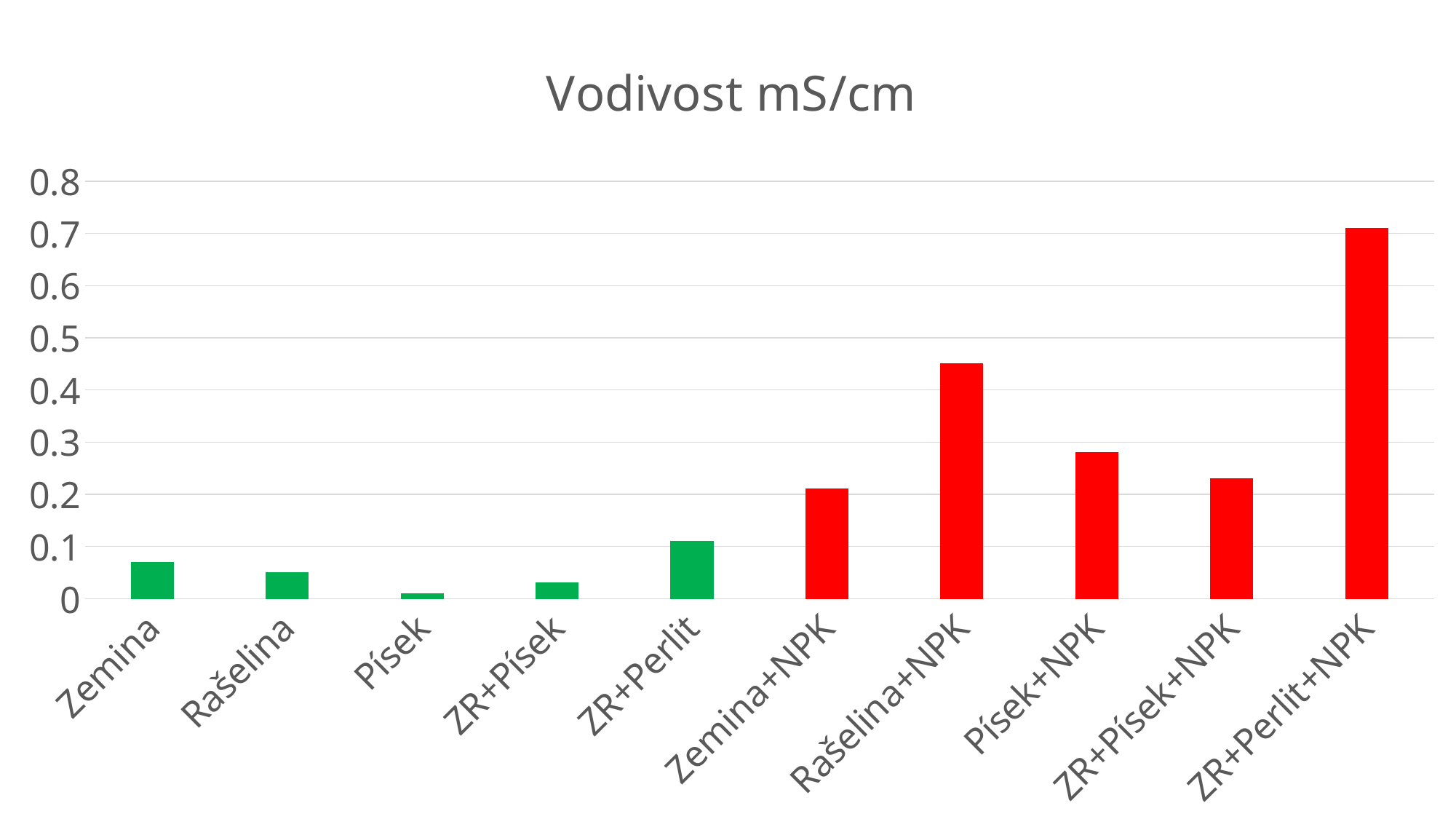
Is the value for Rašelina+NPK greater or less than 0.4? greater Is the value for Písek+NPK greater or less than 0.3? less How many categories are shown on the x axis of the chart? 10 What colour are the bars for the categories with NPK? red Which category has the lowest value in the chart? Písek Which is larger, the value for Rašelina+NPK or the value for Písek+NPK? Rašelina+NPK Is the value for ZR+Perlit+NPK greater or less than 0.6? greater Which category has the highest value in the chart? ZR+Perlit+NPK What type of chart is shown on the slide? bar chart What is the title of the chart? Vodivost mS/cm Which is larger, the value for Zemina or the value for Rašelina? Zemina